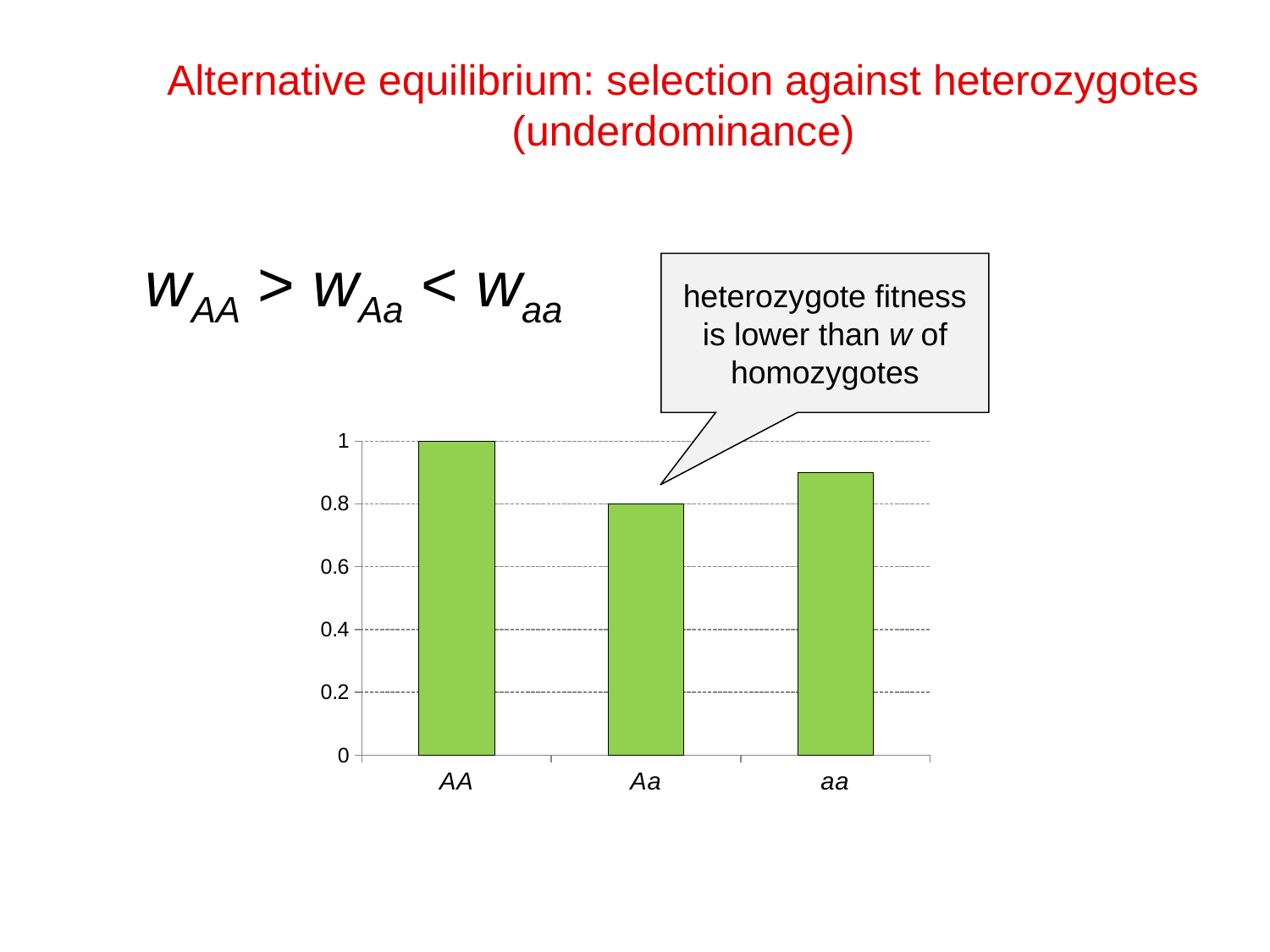
Which category has the highest bar in the chart? AA Which is larger, the value for AA or the value for aa? AA Is the value for aa greater or less than 1? less What is the difference between the values for AA and Aa? 0.2 What kind of chart is shown on the slide? bar chart What colour are the bars in the chart? green Which category has the lowest bar in the chart? Aa What is the value for AA in the chart? 1 How many categories are shown on the x axis of the chart? 3 Is the value for aa greater or less than 0.8? greater